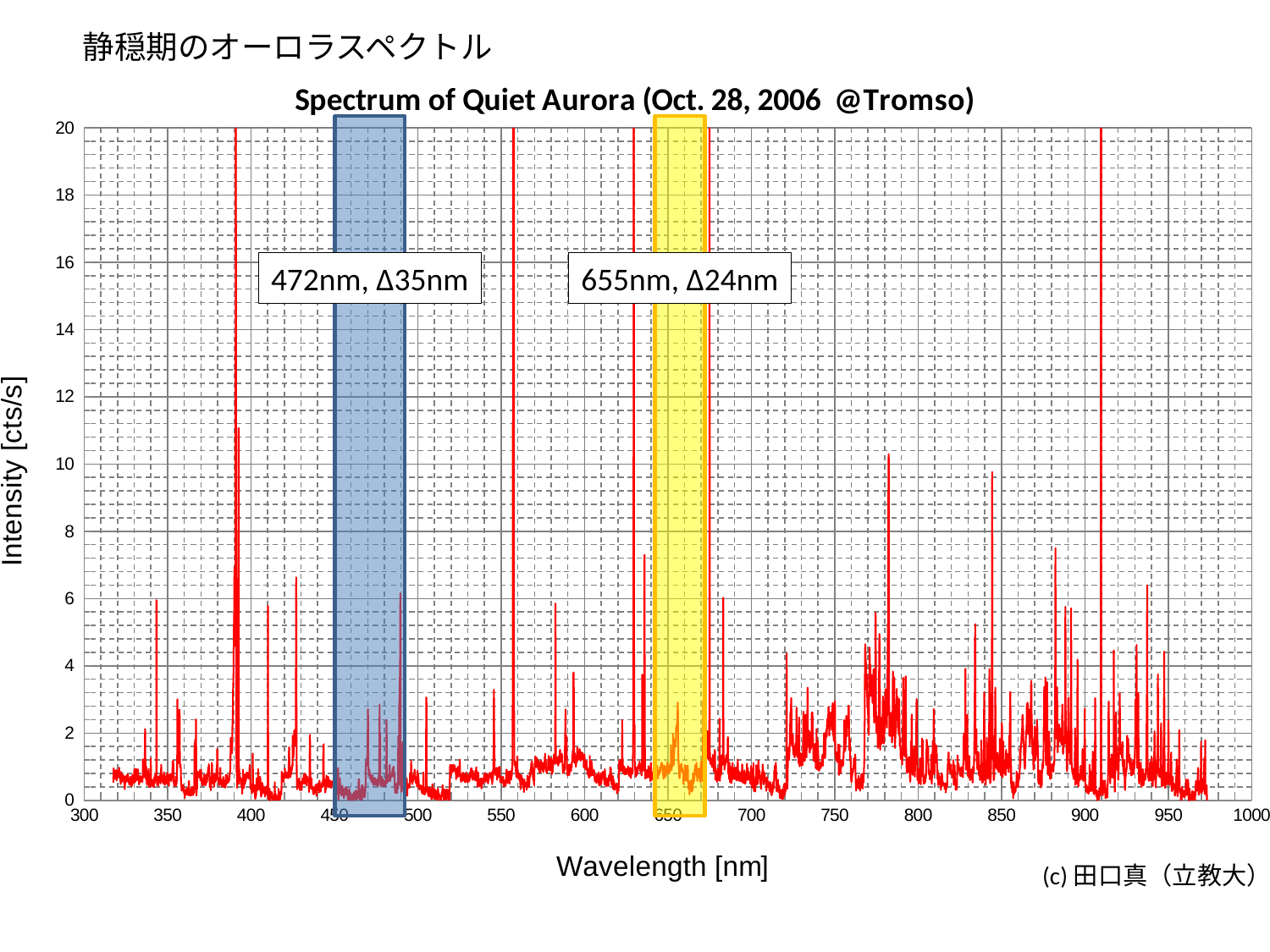
Is the intensity of the peak near 558 nm greater or less than 18? greater Is the intensity of the peak near 845 nm greater or less than 8? greater What is the title of the chart? Spectrum of Quiet Aurora (Oct. 28, 2006 @Tromso) What is the maximum value shown on the y axis? 20 What bandwidth (Δ) is labelled for the yellow shaded band? Δ24nm What kind of chart is shown on the slide? line chart Is the intensity of the peak near 391 nm greater or less than 10? greater What central wavelength is labelled for the blue shaded band? 472nm What is the label of the y axis? Intensity [cts/s] What central wavelength is labelled for the yellow shaded band? 655nm What is the maximum wavelength shown on the x axis? 1000